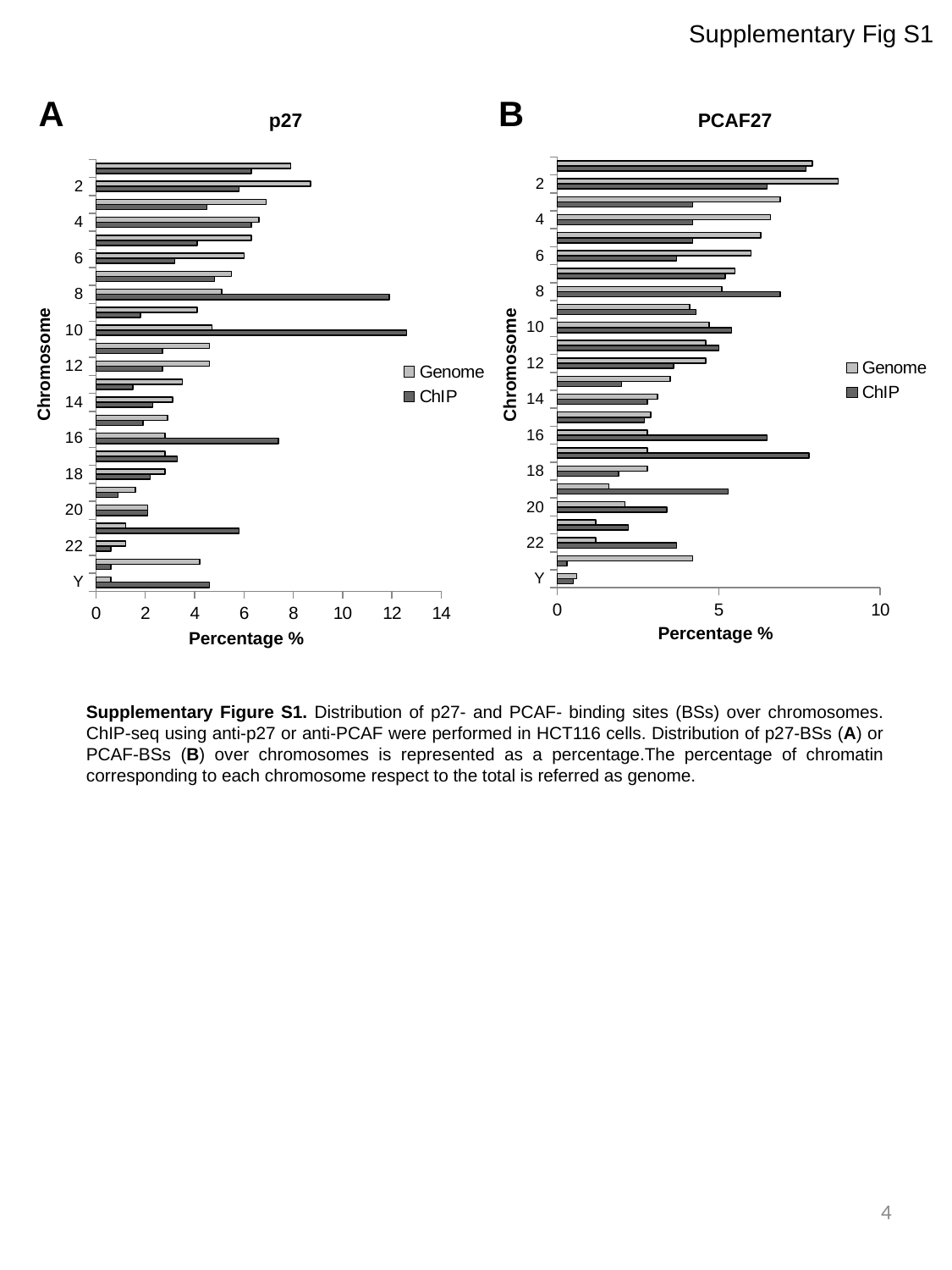
In the PCAF27 chart, is the Genome value for chromosome 2 greater or less than 5? greater In the p27 chart, is the ChIP value for chromosome 10 greater or less than 12? greater In the PCAF27 chart, is the ChIP value for chromosome 16 greater or less than 5? greater What kind of chart is the p27 chart? bar chart How many series does the legend of the PCAF27 chart list? 2 In the p27 chart, which is larger for chromosome 10, the Genome value or the ChIP value? ChIP In the PCAF27 chart, which is larger for chromosome 8, the Genome value or the ChIP value? ChIP What is the title of the x axis of the PCAF27 chart? Percentage % In the p27 chart, which chromosome has the highest ChIP value? 10 In the p27 chart, which is larger for chromosome Y, the Genome value or the ChIP value? ChIP